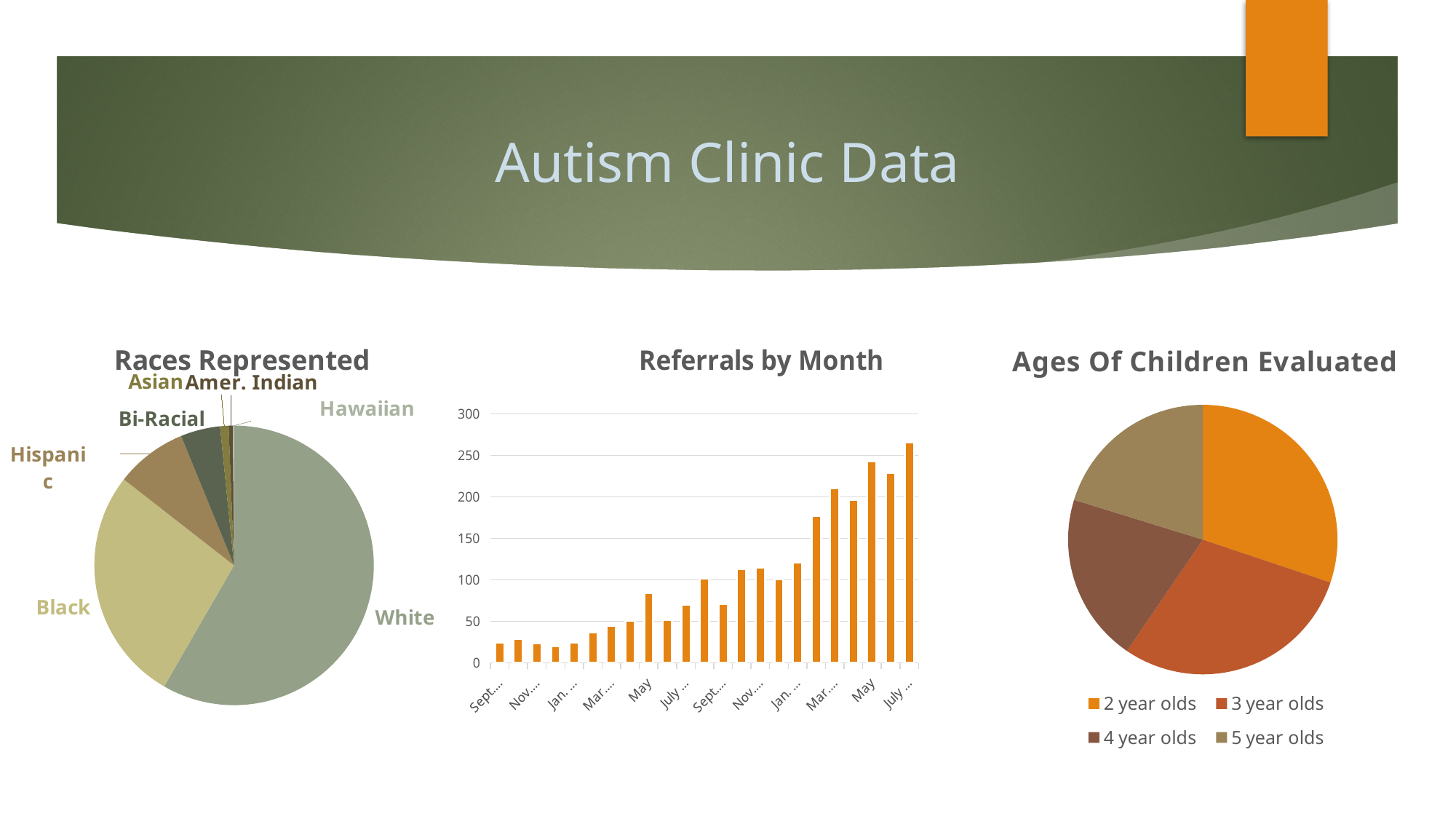
In the "Ages Of Children Evaluated" chart, which slice is larger, 2 year olds or 4 year olds? 2 year olds What kind of chart is the "Races Represented" chart? pie chart What is the title of the chart on the right of the slide? Ages Of Children Evaluated How many slices does the "Races Represented" pie chart have? 7 What kind of chart is the "Referrals by Month" chart? bar chart In the "Races Represented" chart, which slice is larger, Black or Hispanic? Black In the "Referrals by Month" chart, is the value of the first bar greater or less than 50? less In the "Ages Of Children Evaluated" chart, which age group has the largest slice? 2 year olds In the "Referrals by Month" chart, do the values generally rise or fall from left to right? rise How many entries does the legend of the "Ages Of Children Evaluated" chart list? 4 In the "Referrals by Month" chart, is the value of the tallest bar greater or less than 250? greater In the "Races Represented" chart, which race has the largest slice? White